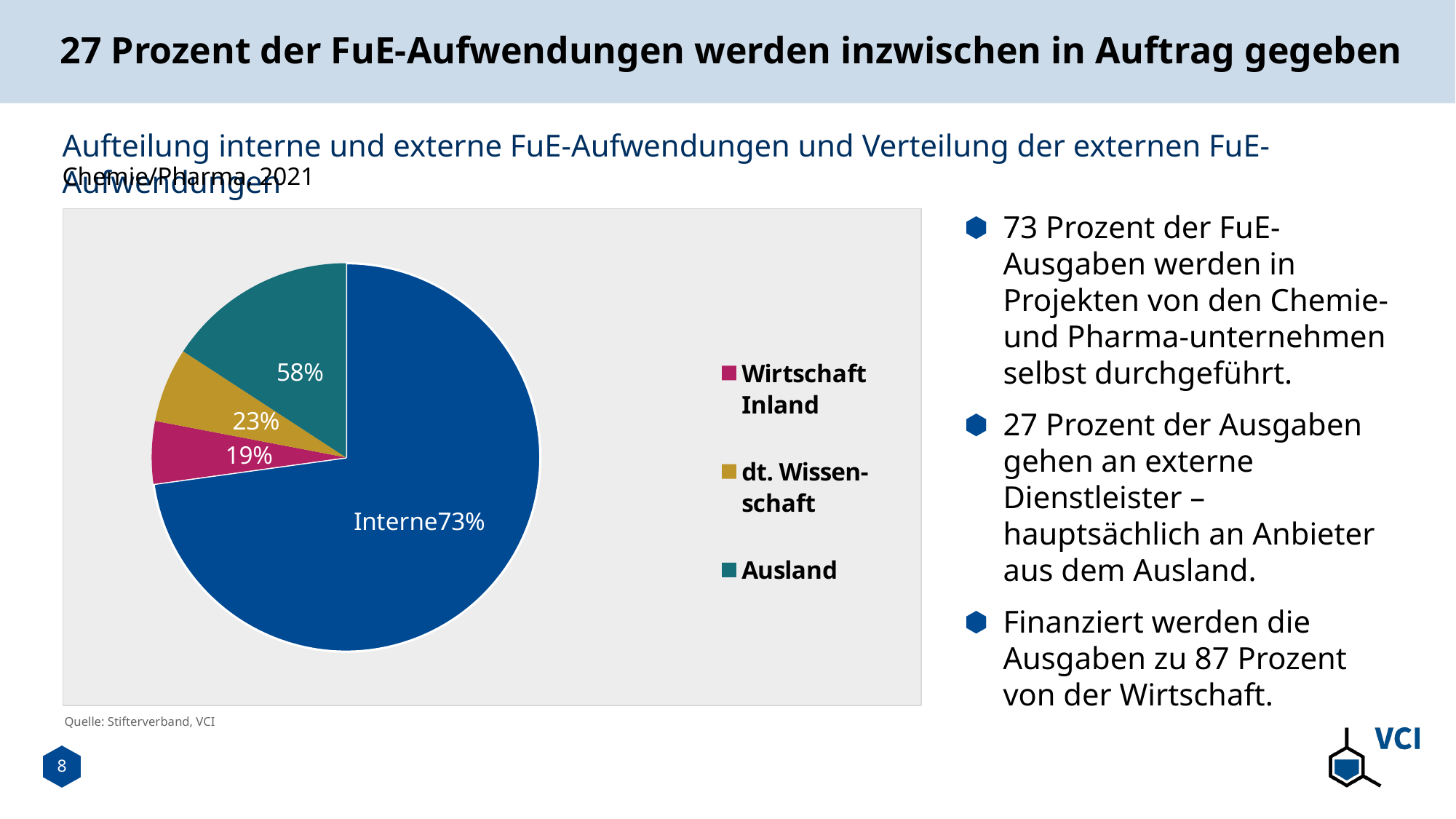
How many slices does the pie chart have? 4 What percentage label is shown on the dt. Wissenschaft slice of the pie chart? 23% Which slice of the pie chart is the largest? Interne What percentage label is shown on the Ausland slice of the pie chart? 58% Which slice of the pie chart is the smallest? Wirtschaft Inland What kind of chart is shown on the slide? pie chart What source is cited below the pie chart? Stifterverband, VCI What percentage label is shown on the Wirtschaft Inland slice of the pie chart? 19% What percentage is shown on the Interne slice of the pie chart? 73% How many entries does the legend of the pie chart list? 3 Which slice is larger in the pie chart: Ausland or dt. Wissenschaft? Ausland What is the difference in percentage points between the labels on the Ausland slice and the dt. Wissenschaft slice? 35